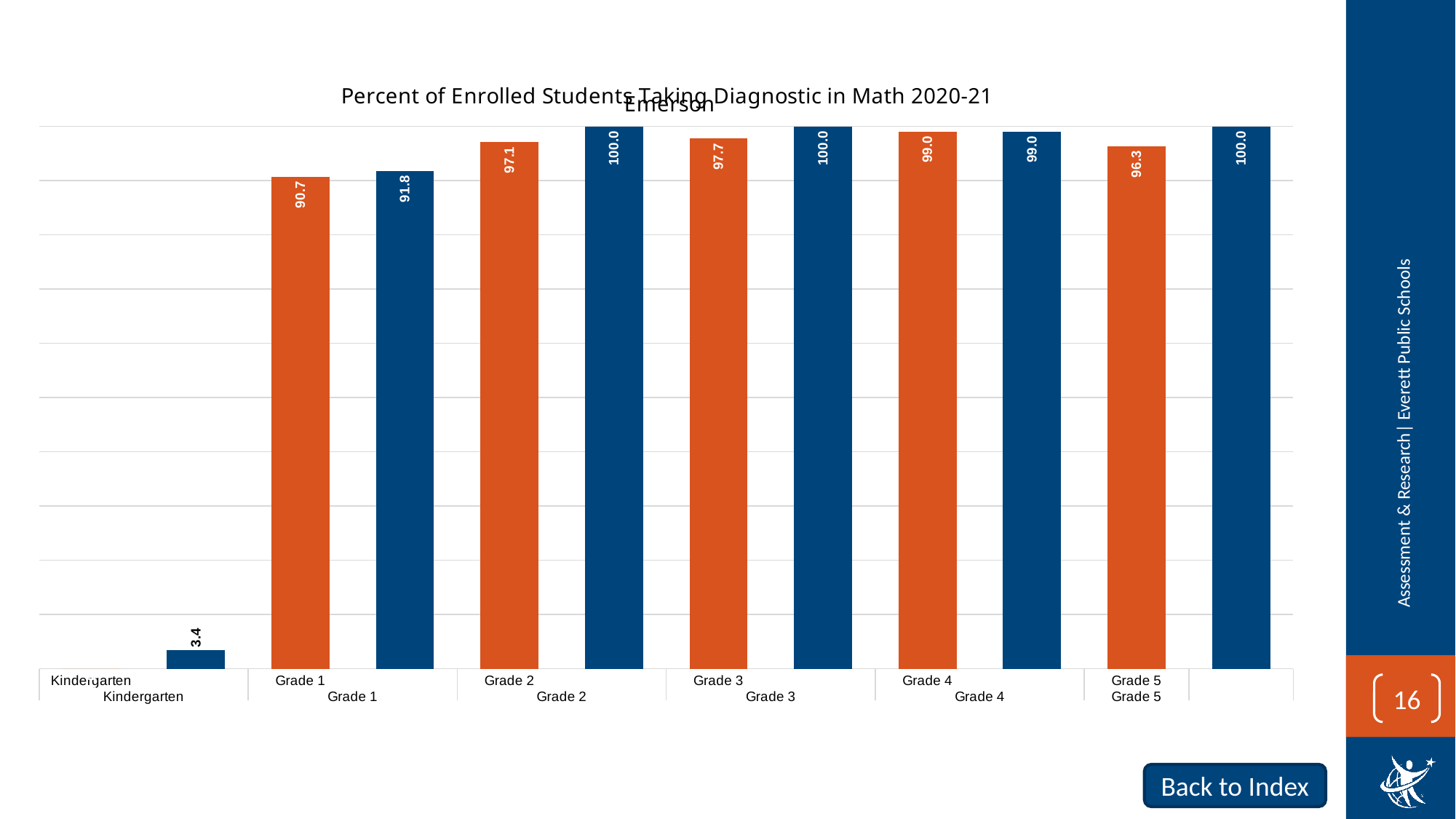
How much higher is the blue bar than the orange bar for Grade 1? 1.1 What is the value of the blue bar for Grade 1? 91.8 How many grade-level categories are shown on the x axis? 6 What is the value of the orange bar for Grade 2? 97.1 What is the difference between the blue bar and the orange bar for Grade 5? 3.7 For Grade 3, which bar is larger, the orange bar or the blue bar? blue What is the value of the blue bar for Kindergarten? 3.4 What type of chart is shown on the slide? bar chart Which grade level has the lowest plotted value? Kindergarten What is the value of the orange bar for Grade 5? 96.3 What is the value of the orange bar for Grade 1? 90.7 What is the value of the orange bar for Grade 4? 99.0